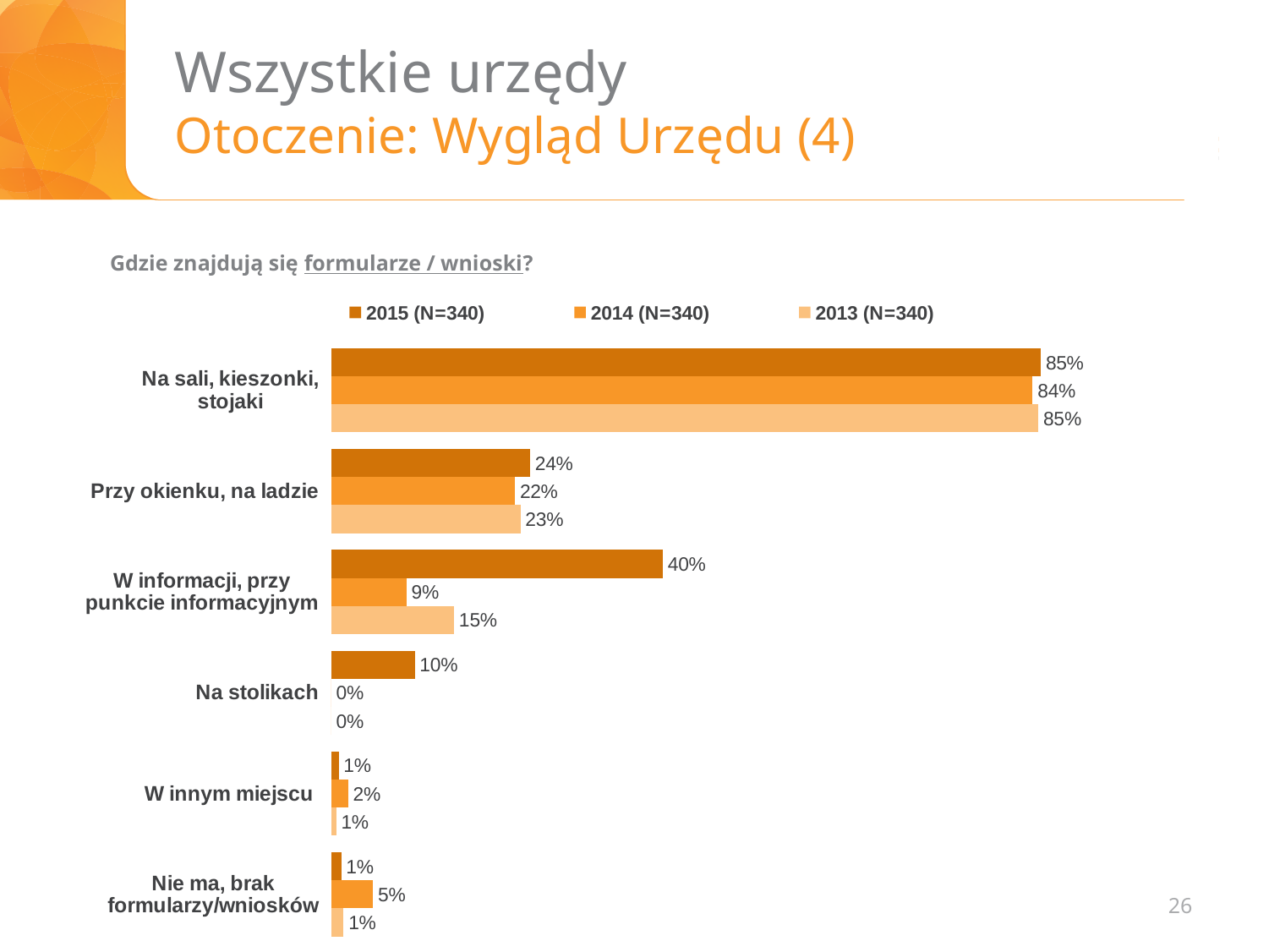
Which category has the highest value in the 2015 (N=340) series? Na sali, kieszonki, stojaki What kind of chart is shown on the slide? Bar chart Which category has the lowest value in the 2014 (N=340) series? Na stolikach How many series does the legend list? 3 What is the value for "Nie ma, brak formularzy/wniosków" in the 2014 (N=340) series? 5% How many categories are shown on the chart? 6 Which is larger for "Przy okienku, na ladzie": the 2015 value or the 2013 value? 2015 What is the value for "Na sali, kieszonki, stojaki" in the 2015 (N=340) series? 85% What is the difference between the 2015 and 2014 values for "W informacji, przy punkcie informacyjnym"? 31 percentage points What question does the chart answer, as stated above it? Gdzie znajdują się formularze / wnioski? What is the value for "W informacji, przy punkcie informacyjnym" in the 2014 (N=340) series? 9% What is the value for "Przy okienku, na ladzie" in the 2013 (N=340) series? 23%